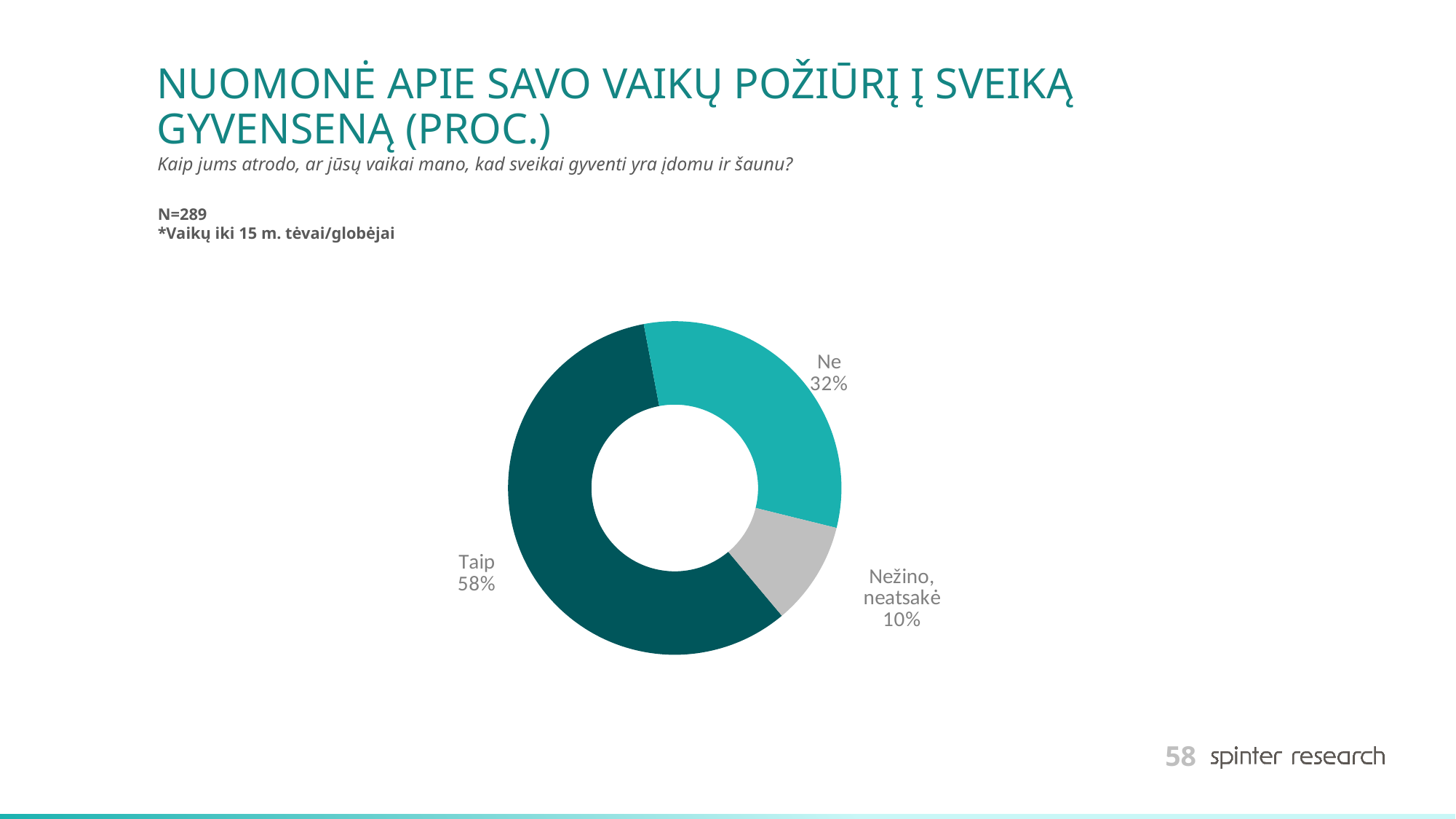
What is the difference in percentage points between "Taip" and "Ne"? 26 Which is larger, the share for "Ne" or the share for "Nežino, neatsakė"? Ne How many answer categories are shown in the chart? 3 What percentage of respondents answered "Nežino, neatsakė"? 10% Which answer category has the smallest share of the chart? Nežino, neatsakė What is the sample size (N) stated on the slide? N=289 What percentage of respondents answered "Taip"? 58% Which answer category has the largest share of the chart? Taip What kind of chart is shown on the slide? Doughnut (pie) chart What colour is the "Nežino, neatsakė" slice? Grey What percentage of respondents answered "Ne"? 32% What is the difference in percentage points between "Ne" and "Nežino, neatsakė"? 22